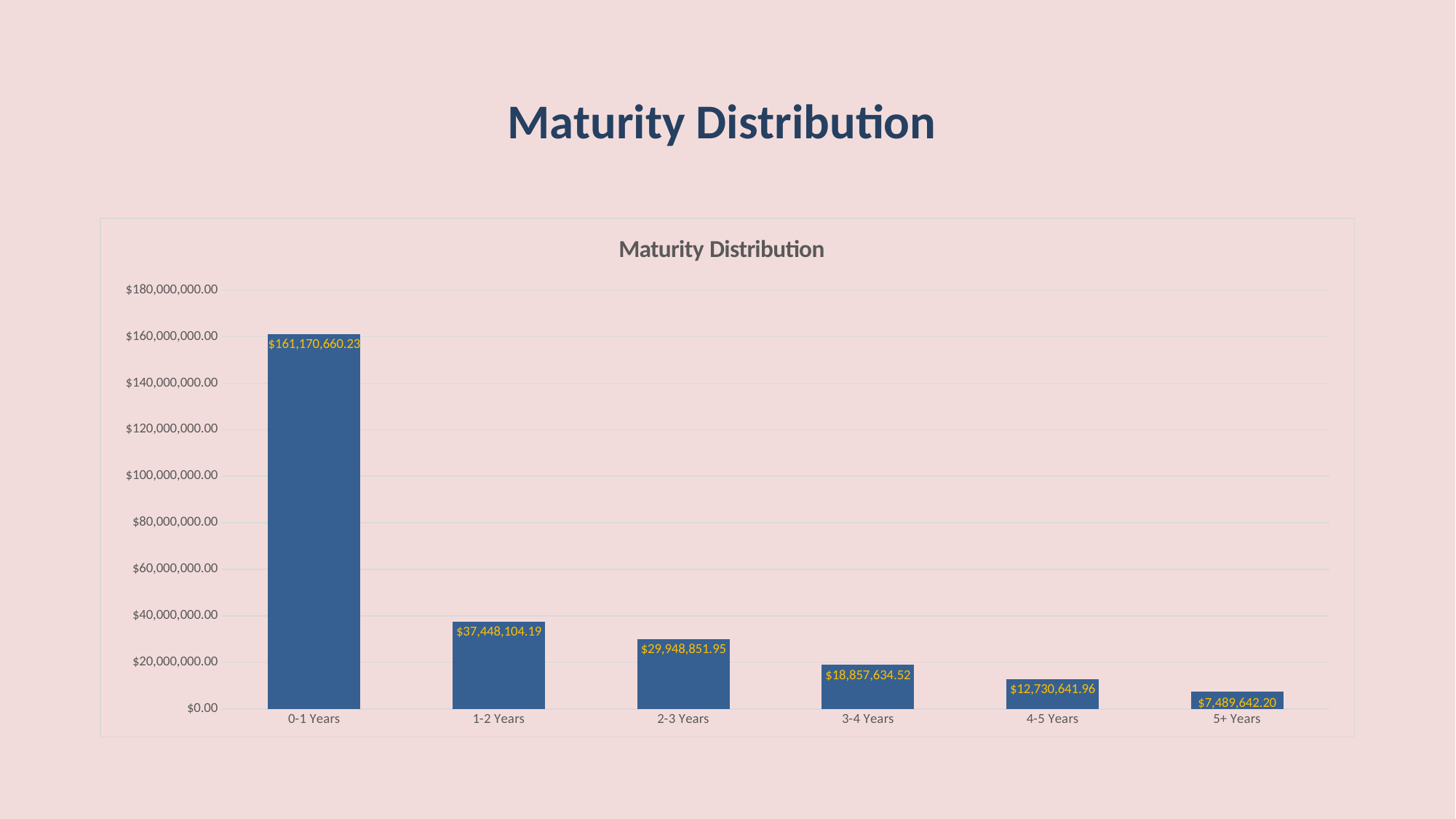
What is the value for 0-1 Years? $161,170,660.23 Do the values rise or fall moving from 0-1 Years to 5+ Years along the x axis? fall What kind of chart is shown on the slide? bar chart Is the value for 1-2 Years greater or less than $40,000,000.00? less Which is larger, the value for 3-4 Years or the value for 4-5 Years? 3-4 Years What is the value for 2-3 Years? $29,948,851.95 Which maturity bucket has the lowest value? 5+ Years What is the difference between the values for 1-2 Years and 2-3 Years? $7,499,252.24 What is the value for 5+ Years? $7,489,642.20 What is the difference between the values for 4-5 Years and 5+ Years? $5,240,999.76 Which maturity bucket has the highest value? 0-1 Years How many maturity buckets are shown on the x axis? 6